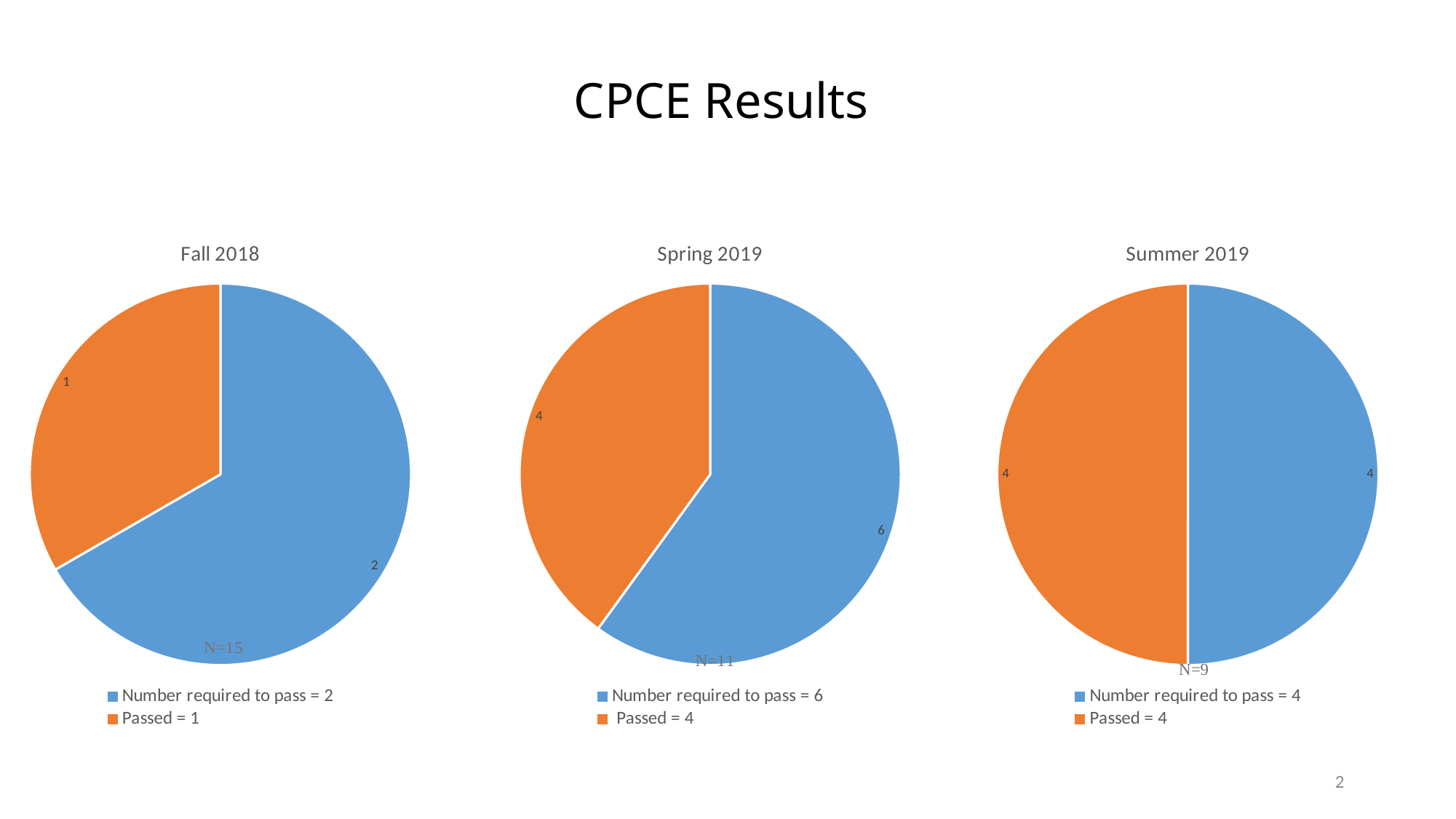
In the Spring 2019 chart, which slice is larger, Number required to pass or Passed? Number required to pass In the Fall 2018 chart, what is the value of the Passed slice? 1 In the Summer 2019 chart, what share of the pie does the Passed slice represent? 50% In the Spring 2019 chart, what is the value of the Number required to pass slice? 6 In the Fall 2018 chart, what is the value of the Number required to pass slice? 2 What kind of chart is the Fall 2018 chart? pie chart In the Spring 2019 chart, what share of the pie does the Passed slice represent? 40% How many slices does the Fall 2018 pie chart have? 2 In the Spring 2019 chart, what is the difference between the Number required to pass and Passed values? 2 In the Summer 2019 chart, what is the value of the Passed slice? 4 What N value is shown below the Spring 2019 chart? N=11 In the Spring 2019 chart, what is the value of the Passed slice? 4